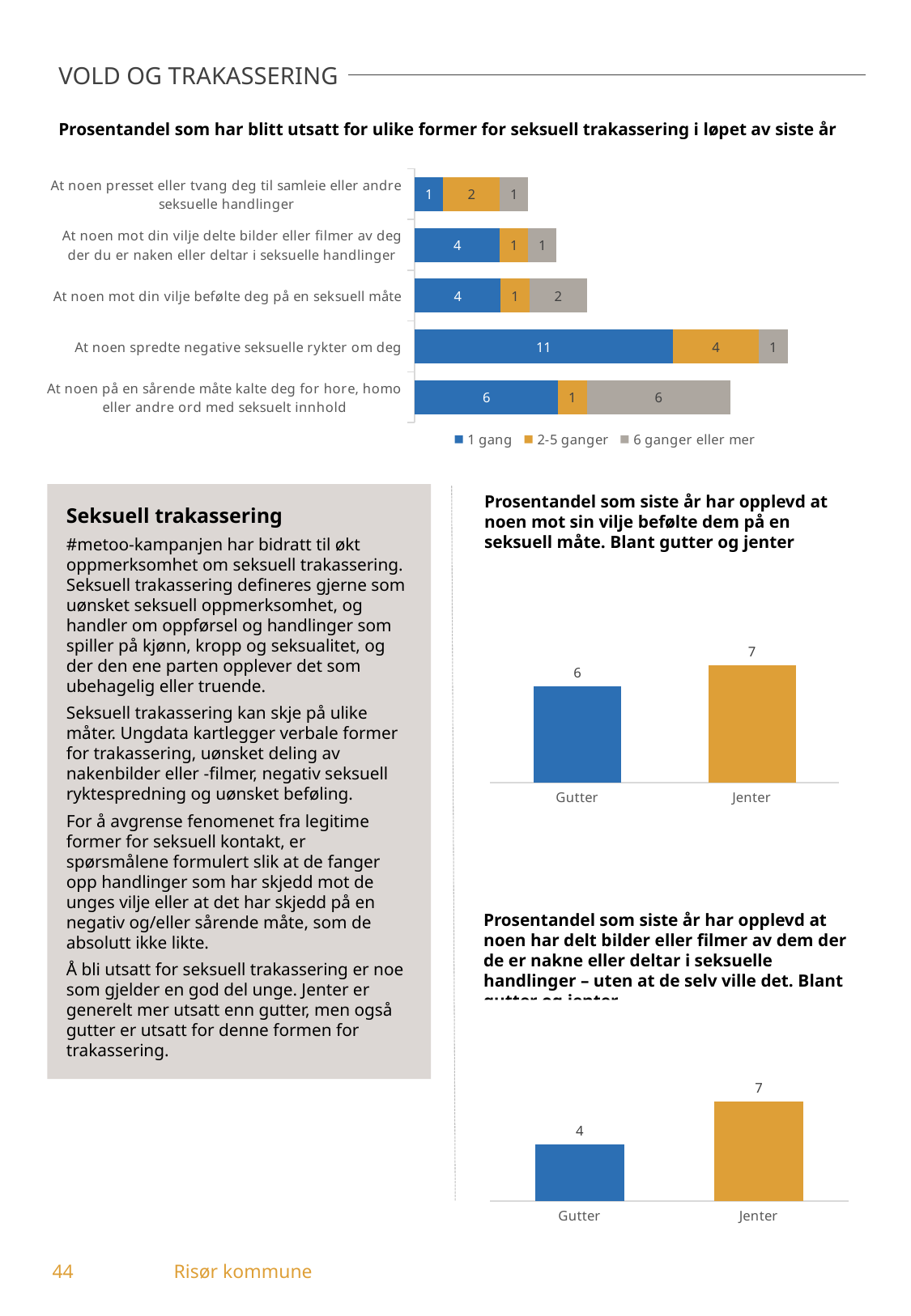
What kind of chart is the top chart on the slide? Stacked bar chart How many categories are shown in the top stacked bar chart? 5 In the top stacked bar chart, what is the total of the bar for 'At noen presset eller tvang deg til samleie eller andre seksuelle handlinger'? 4 In the top stacked bar chart, what is the total of the bar for 'At noen spredte negative seksuelle rykter om deg'? 16 In the bottom-right chart about bilder eller filmer delt uten at de selv ville det, which is larger, Gutter or Jenter? Jenter In the bottom-right chart about bilder eller filmer delt uten at de selv ville det, what is the value for Gutter? 4 In the top stacked bar chart, what is the value of '6 ganger eller mer' for 'At noen på en sårende måte kalte deg for hore, homo eller andre ord med seksuelt innhold'? 6 In the top stacked bar chart, which category has the highest '1 gang' value? At noen spredte negative seksuelle rykter om deg In the top chart 'Prosentandel som har blitt utsatt for ulike former for seksuell trakassering i løpet av siste år', what is the value of '1 gang' for 'At noen spredte negative seksuelle rykter om deg'? 11 In the chart 'Prosentandel som siste år har opplevd at noen mot sin vilje befølte dem på en seksuell måte. Blant gutter og jenter', what is the value for Jenter? 7 How many series does the legend of the top stacked bar chart list? 3 In the chart 'Prosentandel som siste år har opplevd at noen mot sin vilje befølte dem på en seksuell måte. Blant gutter og jenter', what is the difference between Jenter and Gutter? 1